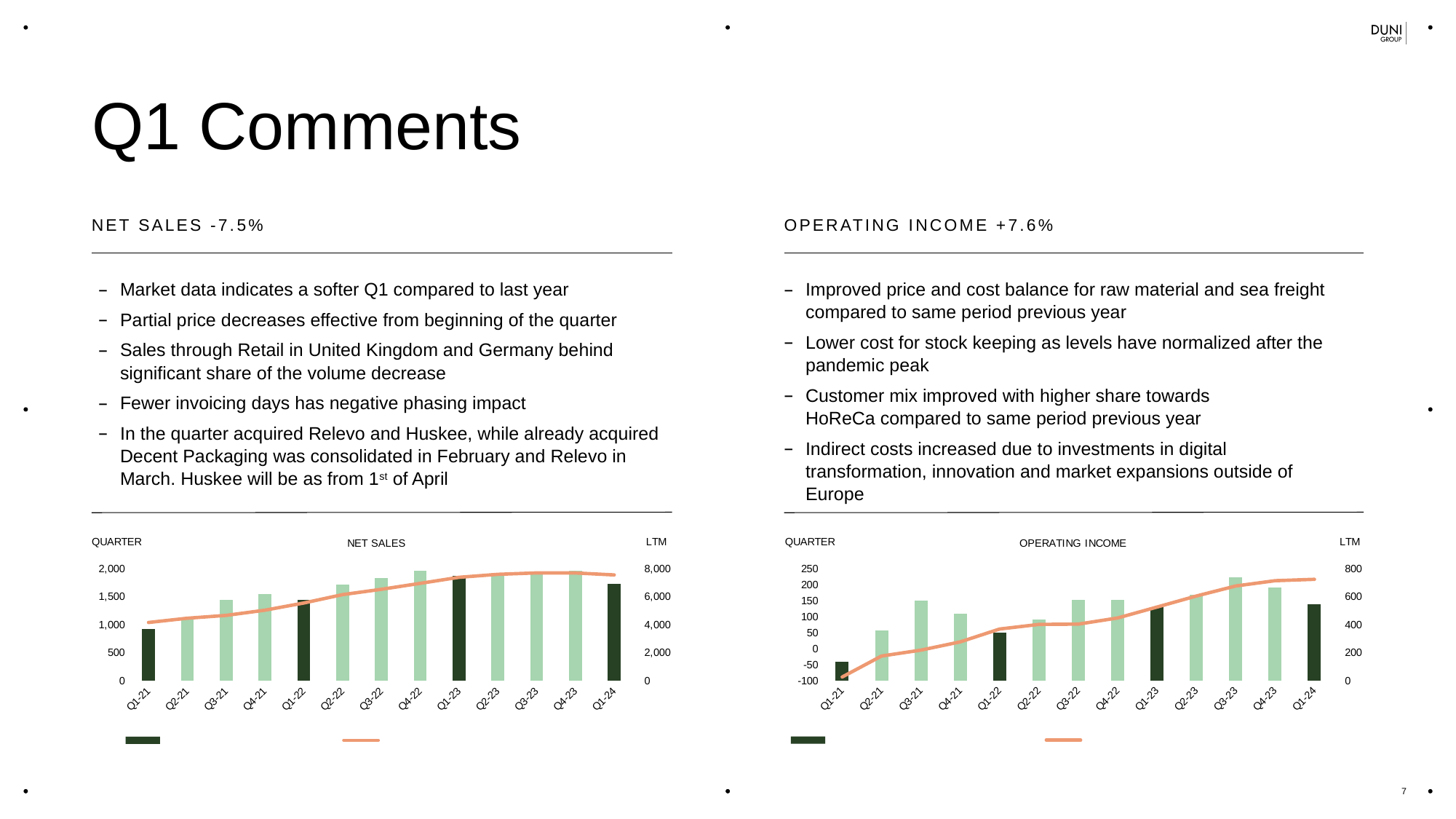
In the OPERATING INCOME chart, which quarter has the lowest bar? Q1-21 In the NET SALES chart, which quarter has the highest bar? Q4-22 What kind of chart is the OPERATING INCOME chart? bar chart with a line In the NET SALES chart, which bar is taller, Q1-23 or Q1-24? Q1-23 In the OPERATING INCOME chart, does the LTM line generally rise or fall from Q1-21 to Q1-24? rise In the NET SALES chart, is the bar for Q1-21 greater or less than 1,000? less In the OPERATING INCOME chart, is the bar for Q1-24 greater or less than 100? greater In the NET SALES chart, how many quarters are shown on the x axis? 13 In the OPERATING INCOME chart, is the bar for Q1-21 greater or less than 0? less In the NET SALES chart, which quarter has the lowest bar? Q1-21 In the OPERATING INCOME chart, which quarter has the highest bar? Q3-23